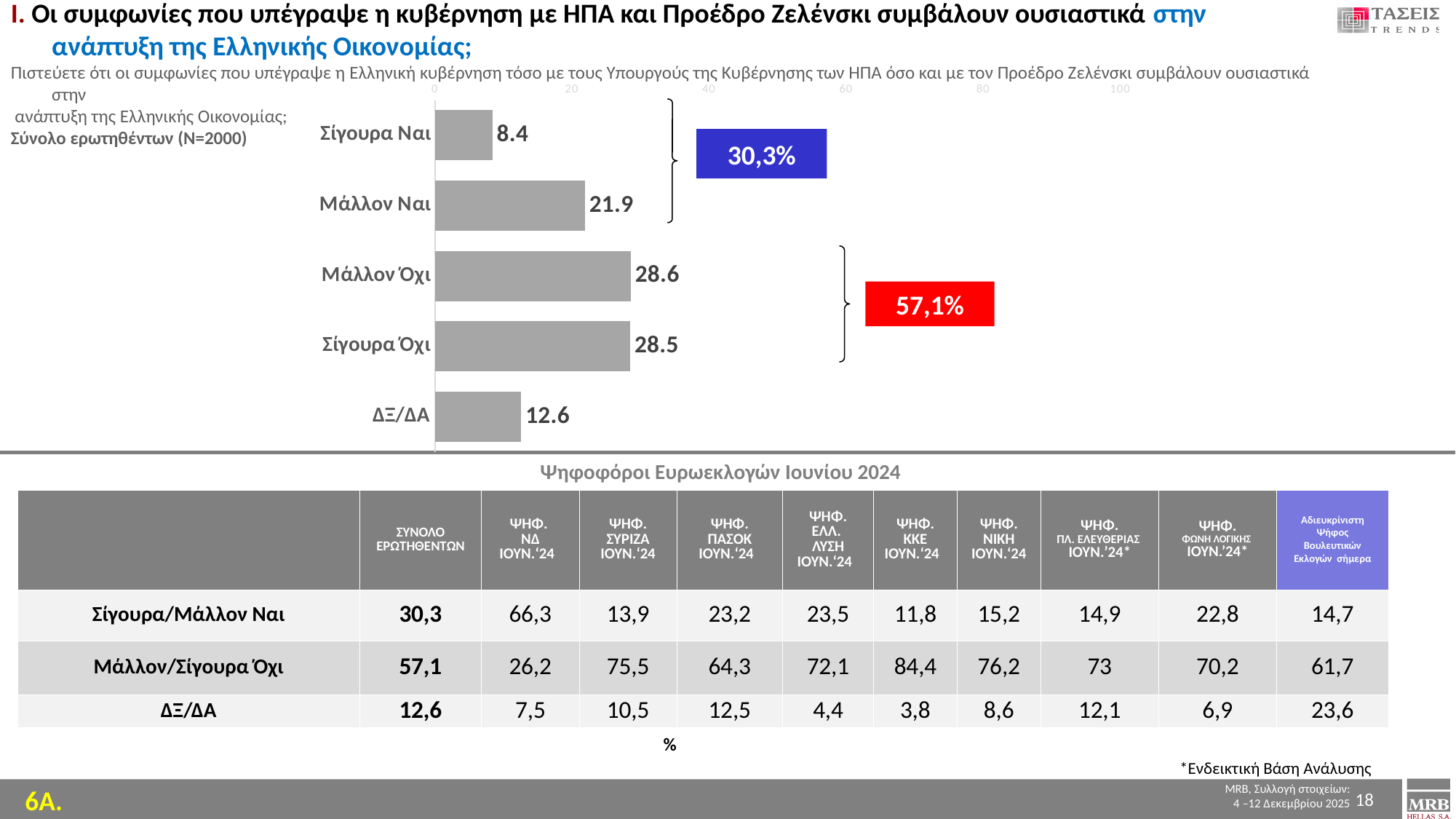
Is the value for Μάλλον Όχι in the bar chart greater or less than 20? greater What is the difference between the values for Σίγουρα Όχι and ΔΞ/ΔΑ in the bar chart? 15.9 How many categories are shown in the bar chart? 5 What is the value for ΔΞ/ΔΑ in the bar chart? 12.6 What is the value for Μάλλον Ναι in the bar chart? 21.9 Which category has the lowest value in the bar chart? Σίγουρα Ναι Which is larger in the bar chart, the value for Μάλλον Ναι or the value for ΔΞ/ΔΑ? Μάλλον Ναι What is the value for Μάλλον Όχι in the bar chart? 28.6 What kind of chart is shown at the top of the slide? bar chart What combined percentage is shown in the red callout box next to the Όχι bars? 57,1% What is the difference between the values for Μάλλον Ναι and Σίγουρα Ναι in the bar chart? 13.5 What is the value for Σίγουρα Ναι in the bar chart? 8.4